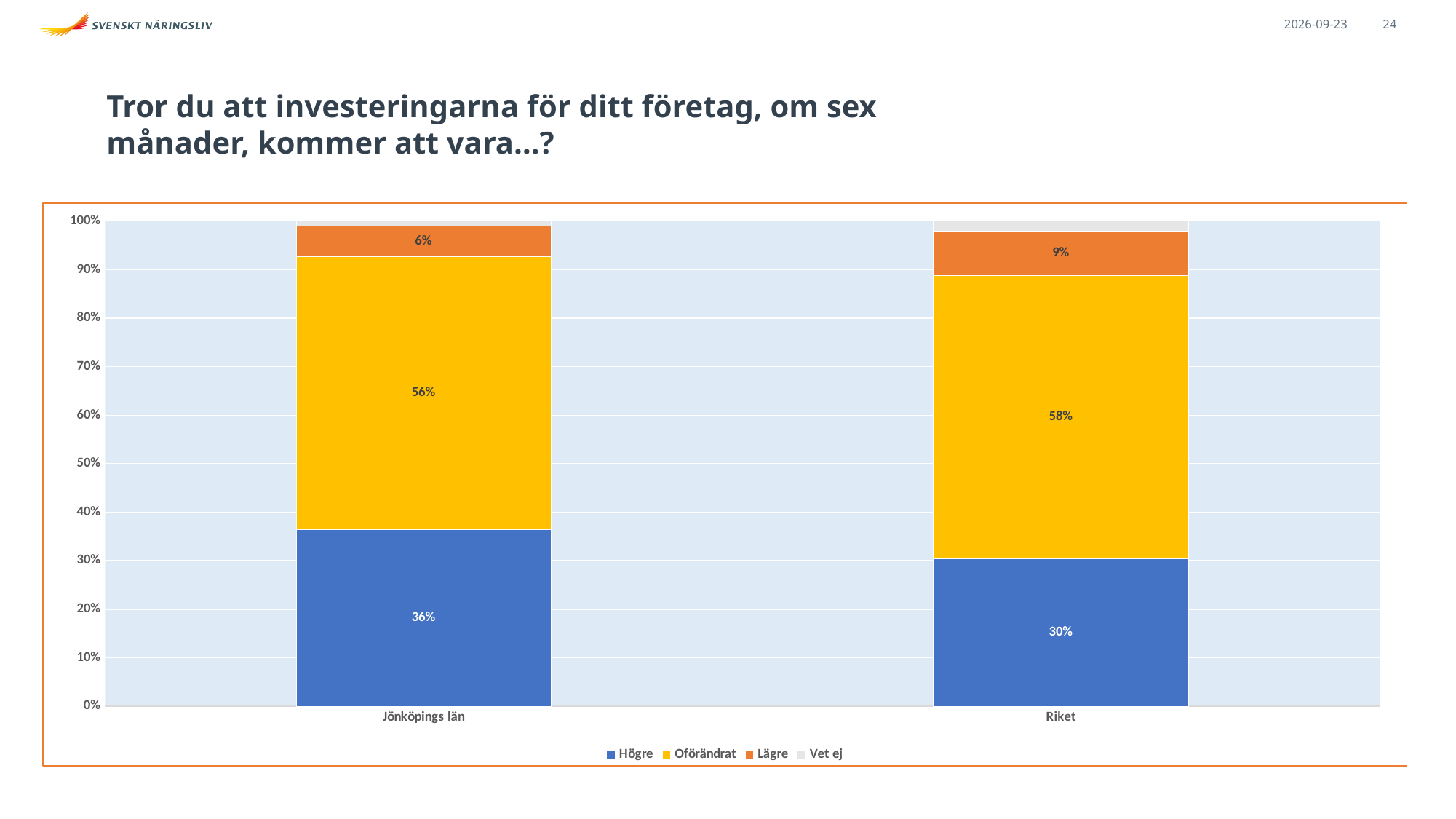
How many series does the legend list? 4 What kind of chart is shown on the slide? Stacked bar chart What percentage of respondents in Jönköpings län answered Högre? 36% Which category has the higher share of Lägre, Jönköpings län or Riket? Riket What is the difference in percentage points between the Högre share in Jönköpings län and in Riket? 6 percentage points How many categories are shown on the x axis? 2 What is the difference in percentage points between the Oförändrat share in Riket and in Jönköpings län? 2 percentage points What is the value for Lägre in Jönköpings län? 6% What is the value for Lägre in Riket? 9% What percentage of respondents in Riket answered Oförändrat? 58% Which legend entry is shown in blue? Högre Which category has the higher share of Högre, Jönköpings län or Riket? Jönköpings län